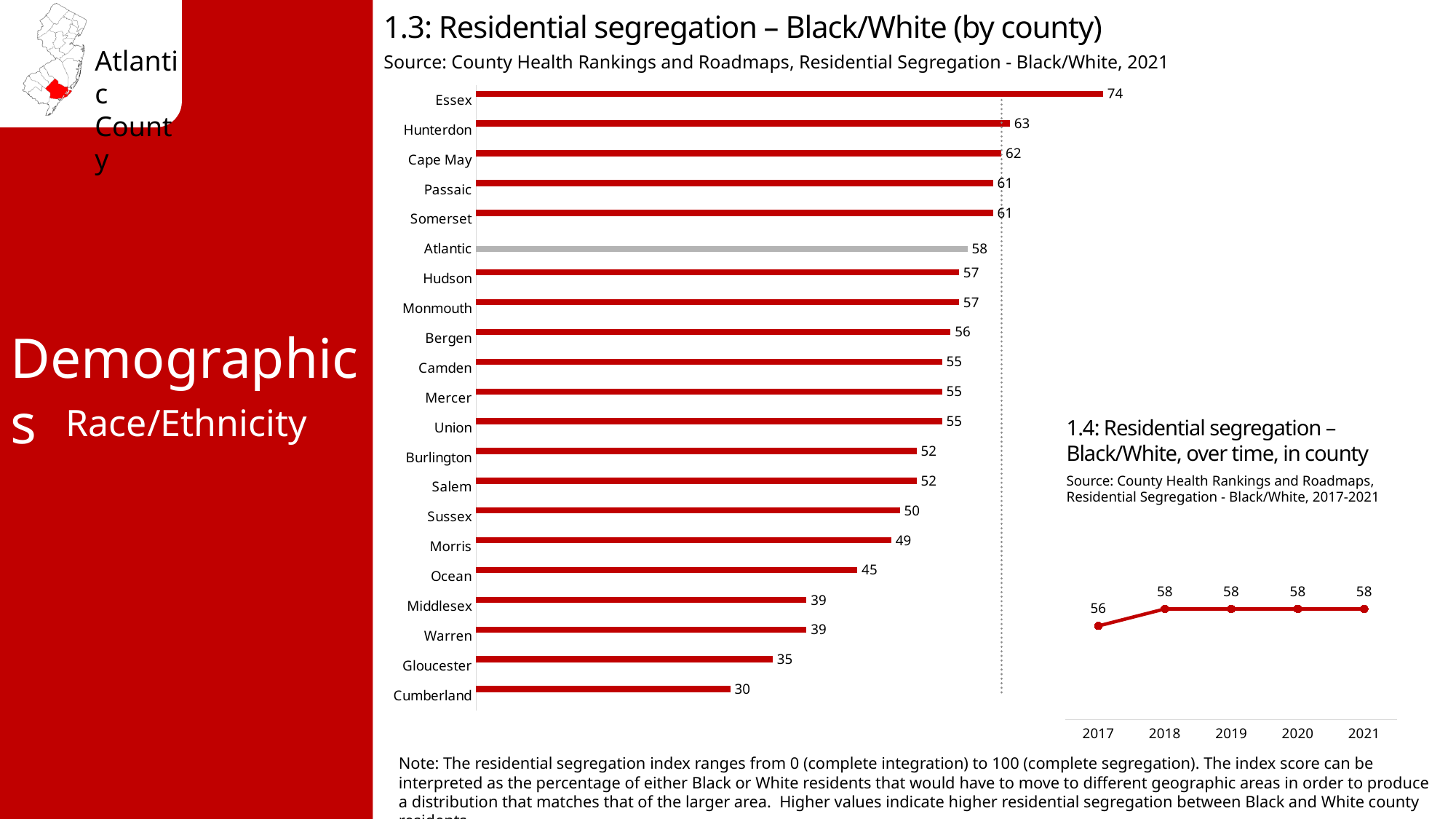
In the chart '1.4: Residential segregation – Black/White, over time, in county', what is the value for 2021? 58 In the chart '1.3: Residential segregation – Black/White (by county)', what is the difference between the values for Essex and Atlantic? 16 What kind of chart is '1.3: Residential segregation – Black/White (by county)'? Bar chart In the chart '1.3: Residential segregation – Black/White (by county)', which has a larger value, Ocean or Gloucester? Ocean In the chart '1.3: Residential segregation – Black/White (by county)', which county has the highest value? Essex In the chart '1.3: Residential segregation – Black/White (by county)', what is the value for Cumberland? 30 In the chart '1.3: Residential segregation – Black/White (by county)', what is the value for Atlantic? 58 How many data points are plotted in the chart '1.4: Residential segregation – Black/White, over time, in county'? 5 In the chart '1.4: Residential segregation – Black/White, over time, in county', what is the value for 2017? 56 How many counties are shown in the chart '1.3: Residential segregation – Black/White (by county)'? 21 What kind of chart is '1.4: Residential segregation – Black/White, over time, in county'? Line chart In the chart '1.3: Residential segregation – Black/White (by county)', which county has the lowest value? Cumberland